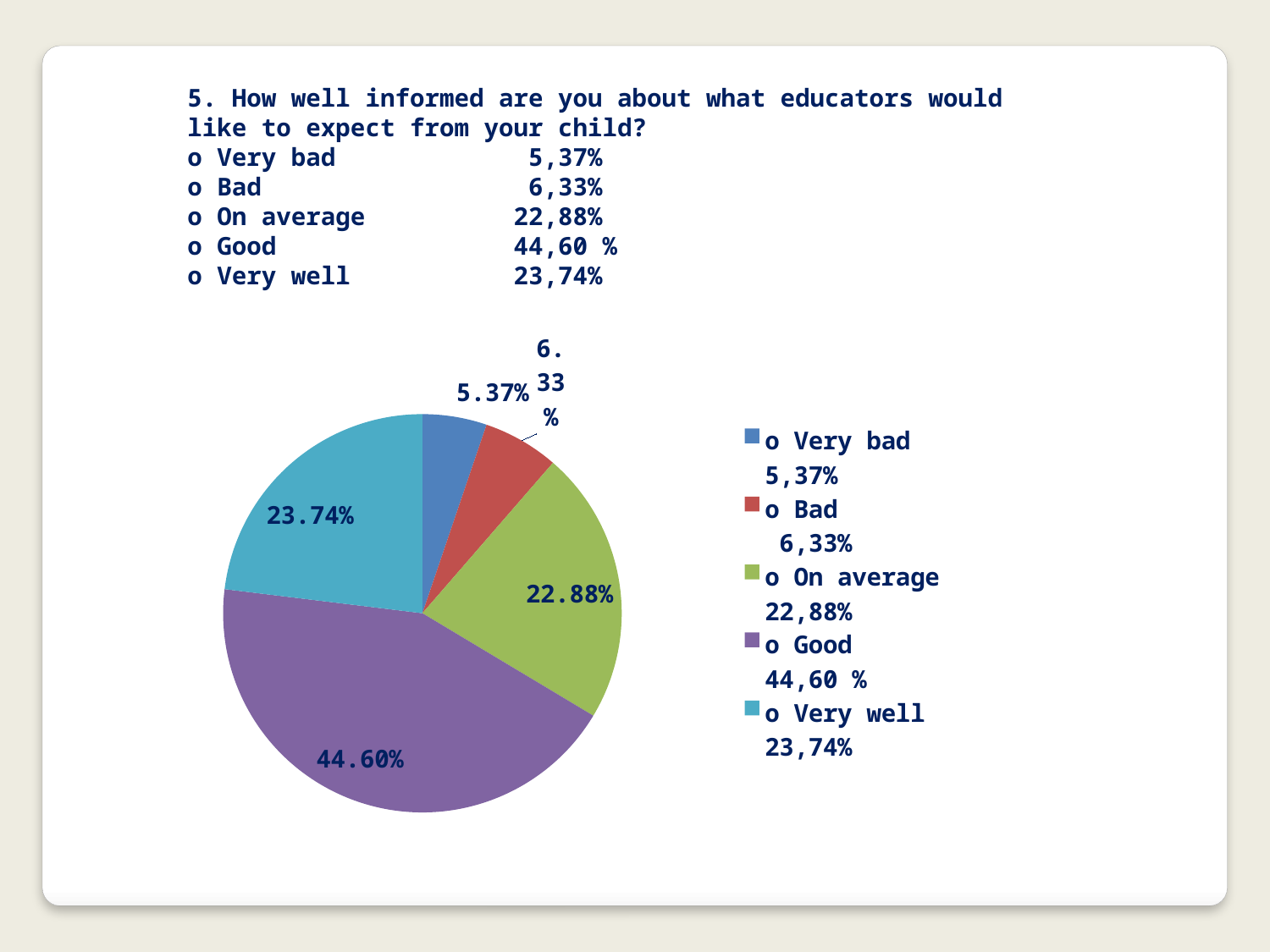
What colour is the 'Good' slice in the pie chart? purple What is the value shown for the 'Good' slice of the pie chart? 44.60% What is the value shown for the 'On average' slice of the pie chart? 22.88% Which slice is larger in the pie chart, 'Good' or 'On average'? Good Which category has the largest slice in the pie chart? Good Which category has the smallest slice in the pie chart? Very bad What is the difference between the 'Good' and 'Very well' values in the pie chart? 20.86% What kind of chart is shown on the slide? pie chart What is the value shown for the 'Bad' slice of the pie chart? 6.33% What is the value shown for the 'Very well' slice of the pie chart? 23.74% What is the value shown for the 'Very bad' slice of the pie chart? 5.37% How many slices does the pie chart have? 5